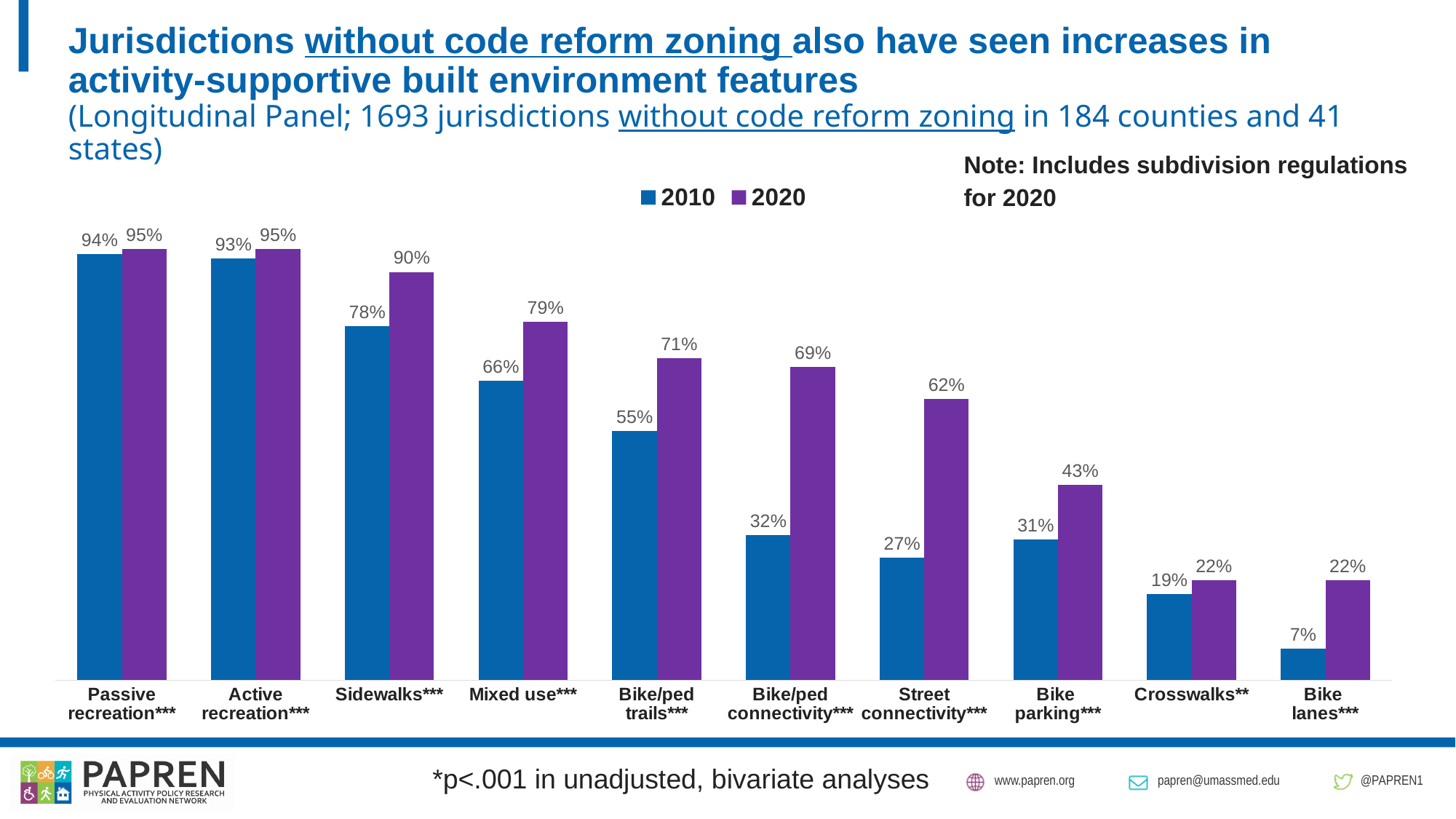
Which colour represents the 2020 series? Purple Which category has the highest 2010 value? Passive recreation What is the 2020 value for Sidewalks? 90% What is the difference between the 2020 and 2010 values for Bike/ped connectivity? 37 percentage points What is the 2010 value for Street connectivity? 27% How many series does the legend list? 2 What kind of chart is shown on the slide? Bar chart What is the 2010 value for Bike lanes? 7% Which is larger: the 2020 value for Mixed use or the 2020 value for Bike/ped trails? Mixed use What is the difference between the 2020 and 2010 values for Street connectivity? 35 percentage points How many categories are shown on the x axis? 10 Which category has the lowest 2010 value? Bike lanes